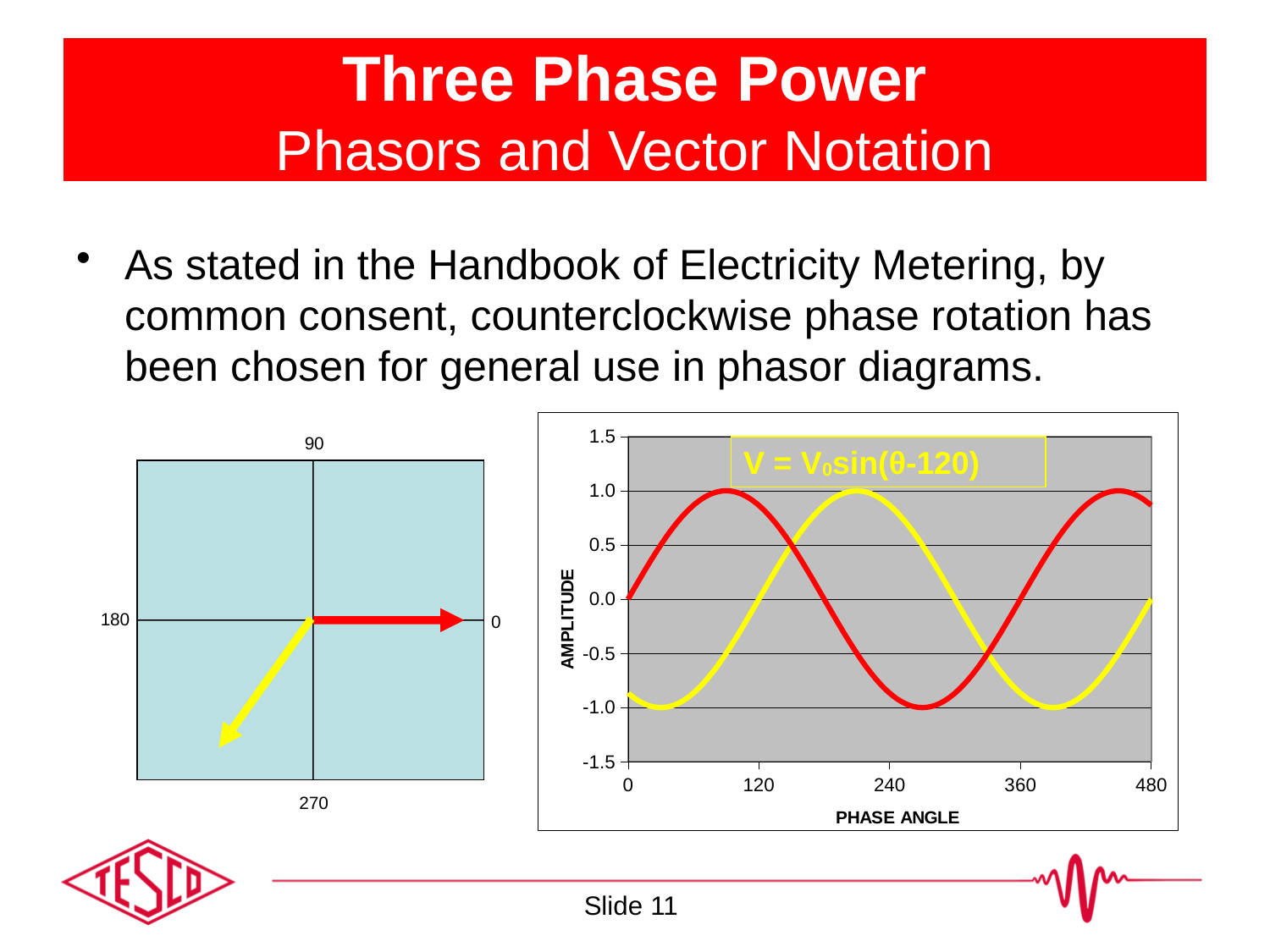
On the right-hand chart, what is the maximum amplitude reached by the red curve? 1.0 On the right-hand chart, what is the minimum amplitude reached by the yellow curve? -1.0 On the right-hand chart, what is the amplitude of the red curve at phase angle 0? 0.0 On the right-hand chart, is the amplitude of the yellow curve at phase angle 0 greater or less than 0.0? less How many curves are plotted on the right-hand chart? 2 How many tick labels are shown on the horizontal axis of the right-hand chart? 5 On the right-hand chart, does the red curve rise or fall between phase angle 120 and phase angle 240? fall On the right-hand chart, at phase angle 240, which curve has the higher amplitude, red or yellow? yellow On the right-hand chart, what equation is printed in the yellow label? V = V₀sin(θ-120) On the right-hand chart, what is the label of the horizontal axis? PHASE ANGLE On the right-hand chart, is the amplitude of the red curve at phase angle 240 greater or less than -0.5? less What kind of chart is the chart on the right of the slide? line chart